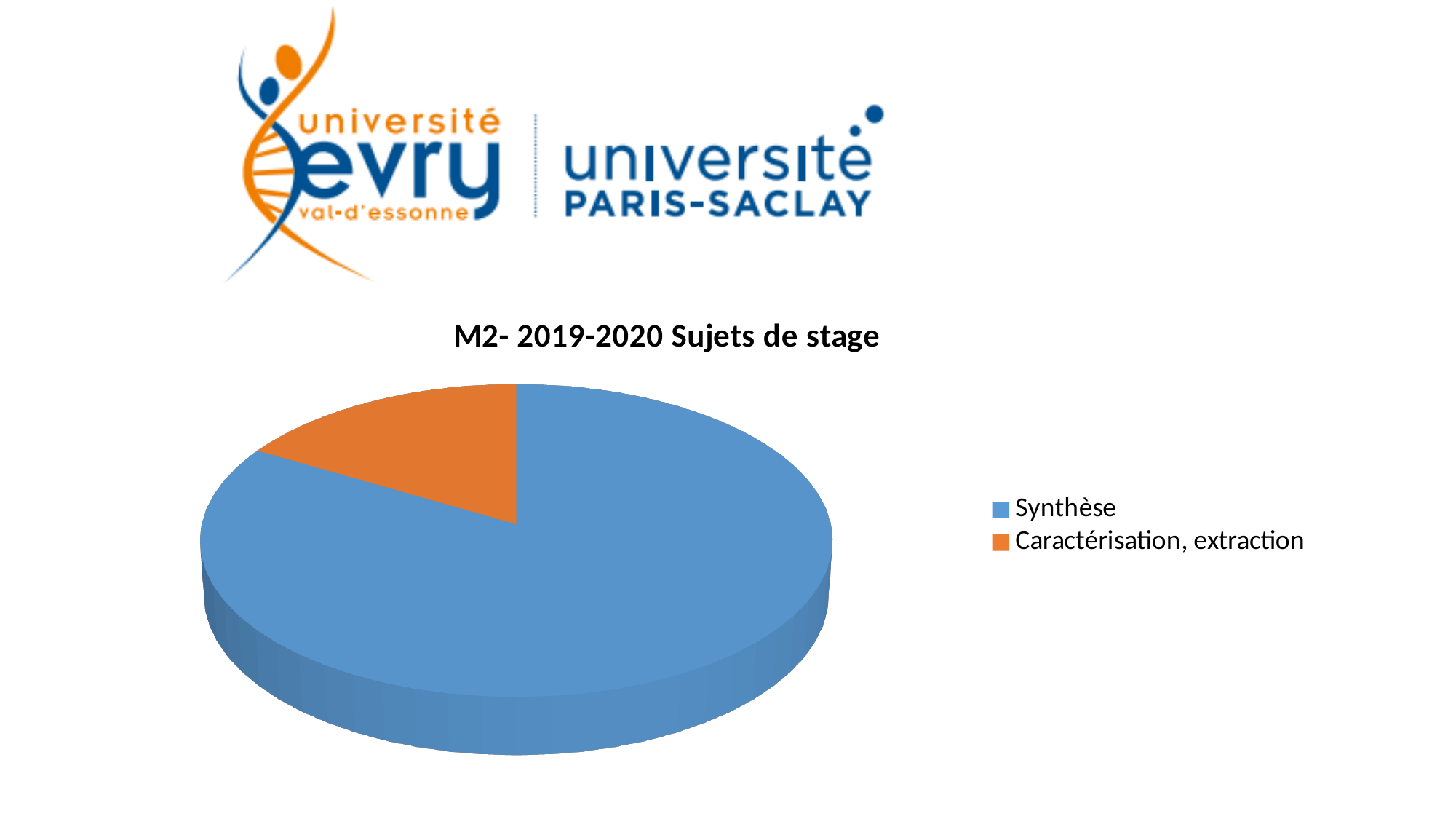
Does the Synthèse slice take up more or less than half of the pie? more How many categories does the pie chart show? 2 Which category has the largest slice of the pie? Synthèse Which slice is larger, Synthèse or Caractérisation, extraction? Synthèse What is the title of the chart? M2- 2019-2020 Sujets de stage How many entries does the legend list? 2 Which colour represents Synthèse in the pie chart? blue Which category has the smallest slice of the pie? Caractérisation, extraction What kind of chart is shown on the slide? pie chart